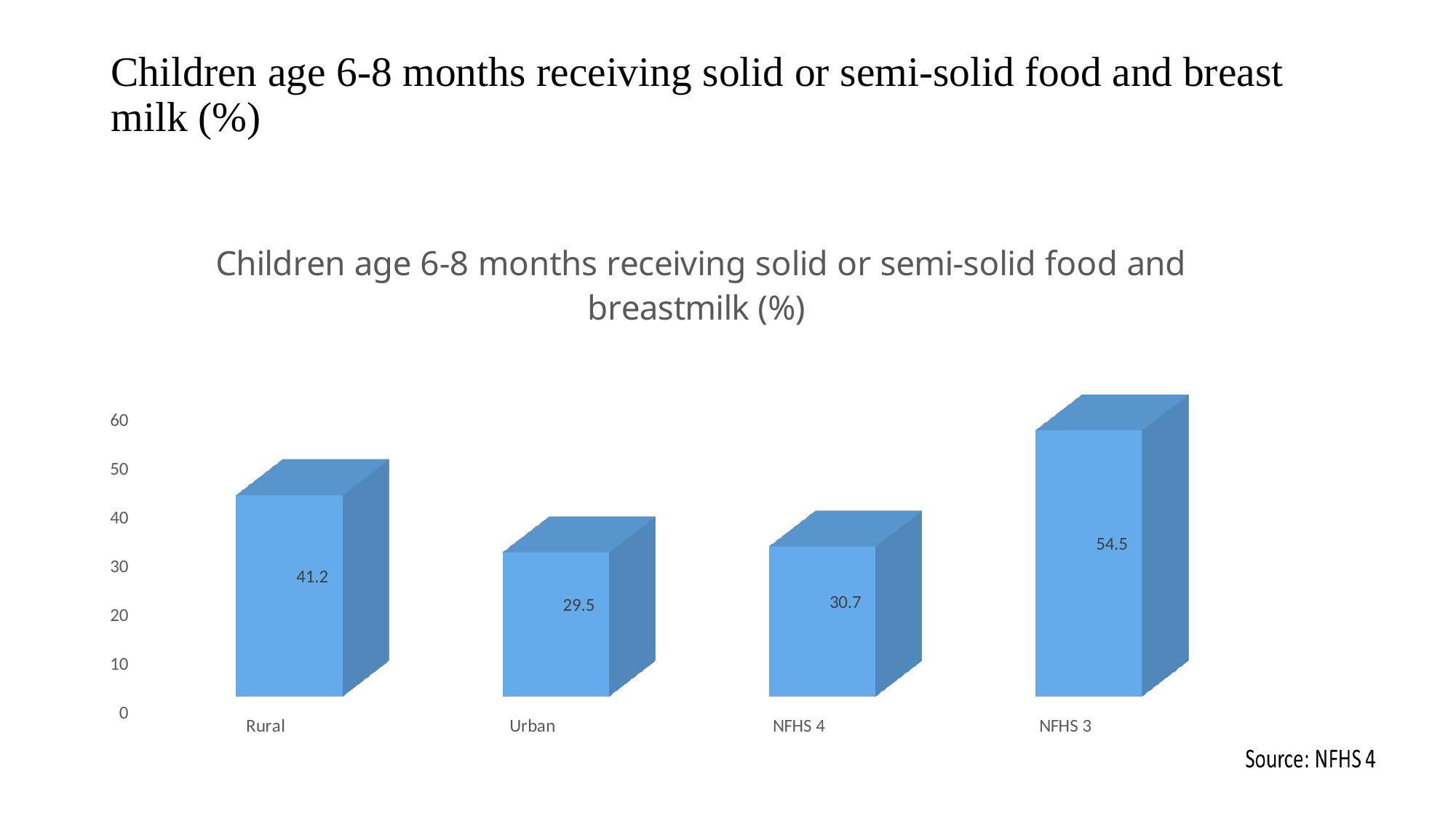
What kind of chart is shown on the slide? Bar chart What is the value for Urban? 29.5 What is the value for Rural? 41.2 Which is larger, the value for Rural or the value for Urban? Rural What is the difference between the Rural and Urban values? 11.7 What is the difference between the NFHS 3 and NFHS 4 values? 23.8 What is the value for NFHS 4? 30.7 What is the value for NFHS 3? 54.5 Which category has the highest value? NFHS 3 Which category has the lowest value? Urban Is the value for NFHS 3 greater or less than 50? greater How many categories are shown on the x axis? 4